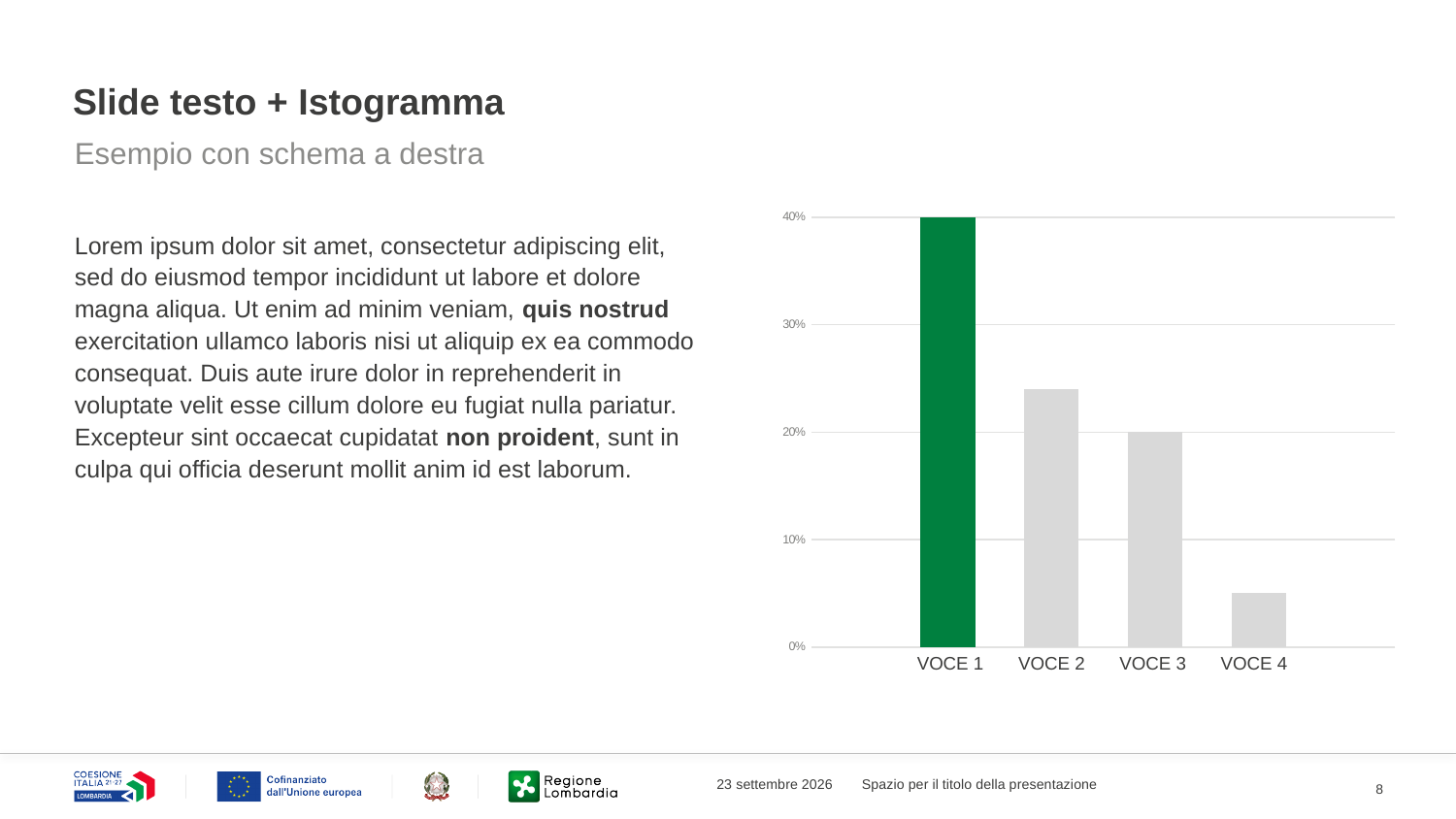
Is the value for VOCE 2 greater or less than 30%? less Which is larger, the value for VOCE 2 or the value for VOCE 3? VOCE 2 What kind of chart is shown on the slide? bar chart Do the values rise or fall from VOCE 1 to VOCE 4 along the x axis? fall What is the value for VOCE 3? 20% Is the value for VOCE 2 greater or less than 20%? greater Which category has the highest value in the chart? VOCE 1 Is the value for VOCE 4 greater or less than 10%? less Which category has the lowest value in the chart? VOCE 4 How many categories are shown on the x axis of the chart? 4